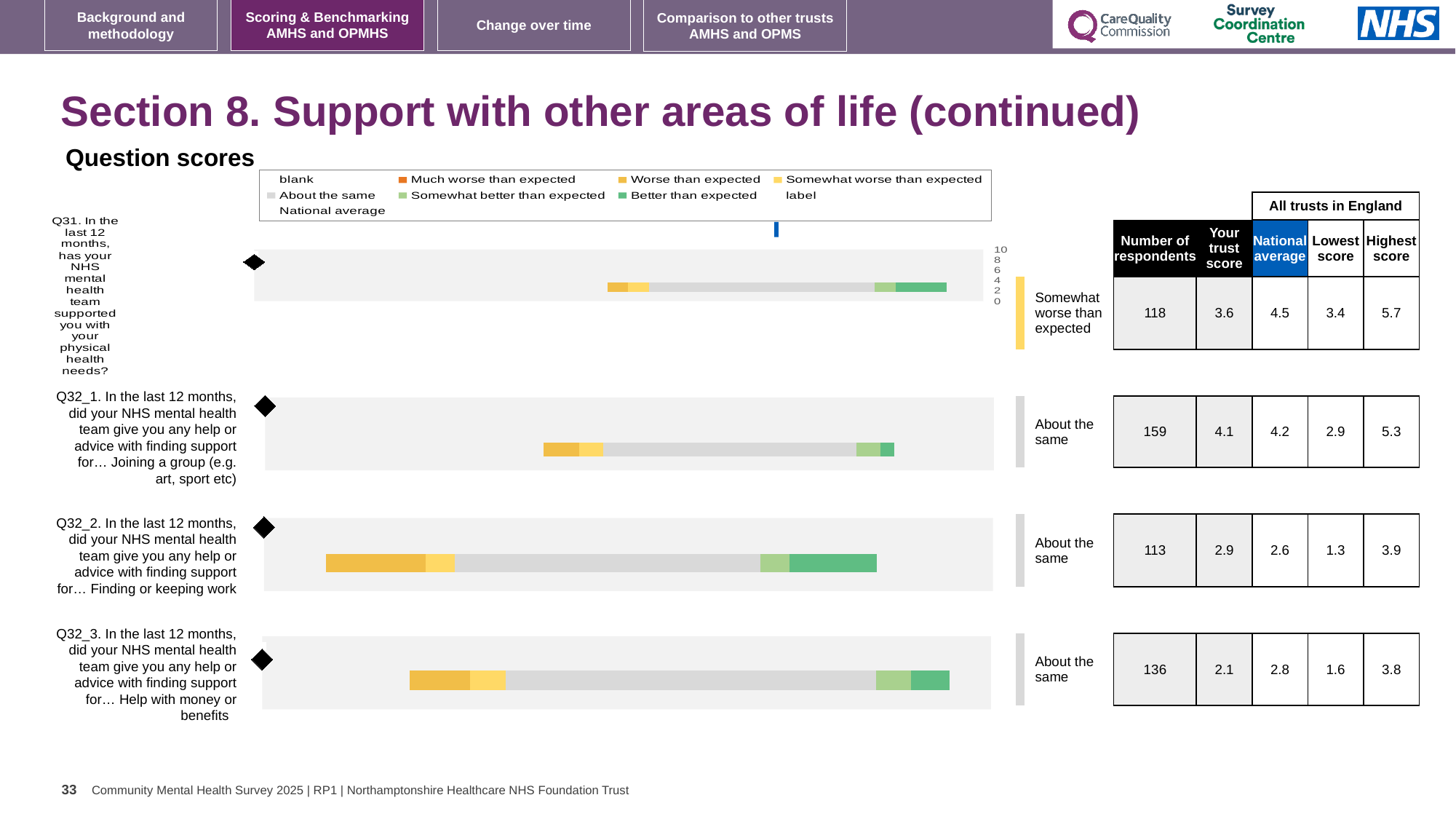
Which question has the highest number of respondents? Q32_1 (159) How many questions (bars) are shown in the question scores chart? 4 What kind of chart is used to show the question scores on this slide? bar chart For Q32_2 (finding or keeping work), which is larger: your trust score or the national average? Your trust score (2.9) In the chart legend, which colour represents 'Better than expected'? green What is the difference between the highest score and the lowest score for Q31? 2.3 What is the number of respondents shown for Q31 (support with physical health needs)? 118 What is 'Your trust score' for Q31 (support with physical health needs)? 3.6 Which benchmark category is shown for Q31 (support with physical health needs)? Somewhat worse than expected What is the highest score shown for Q32_3 (help with money or benefits)? 3.8 Which benchmark category is shown for Q32_1 (joining a group)? About the same What is the national average shown for Q32_2 (finding or keeping work)? 2.6